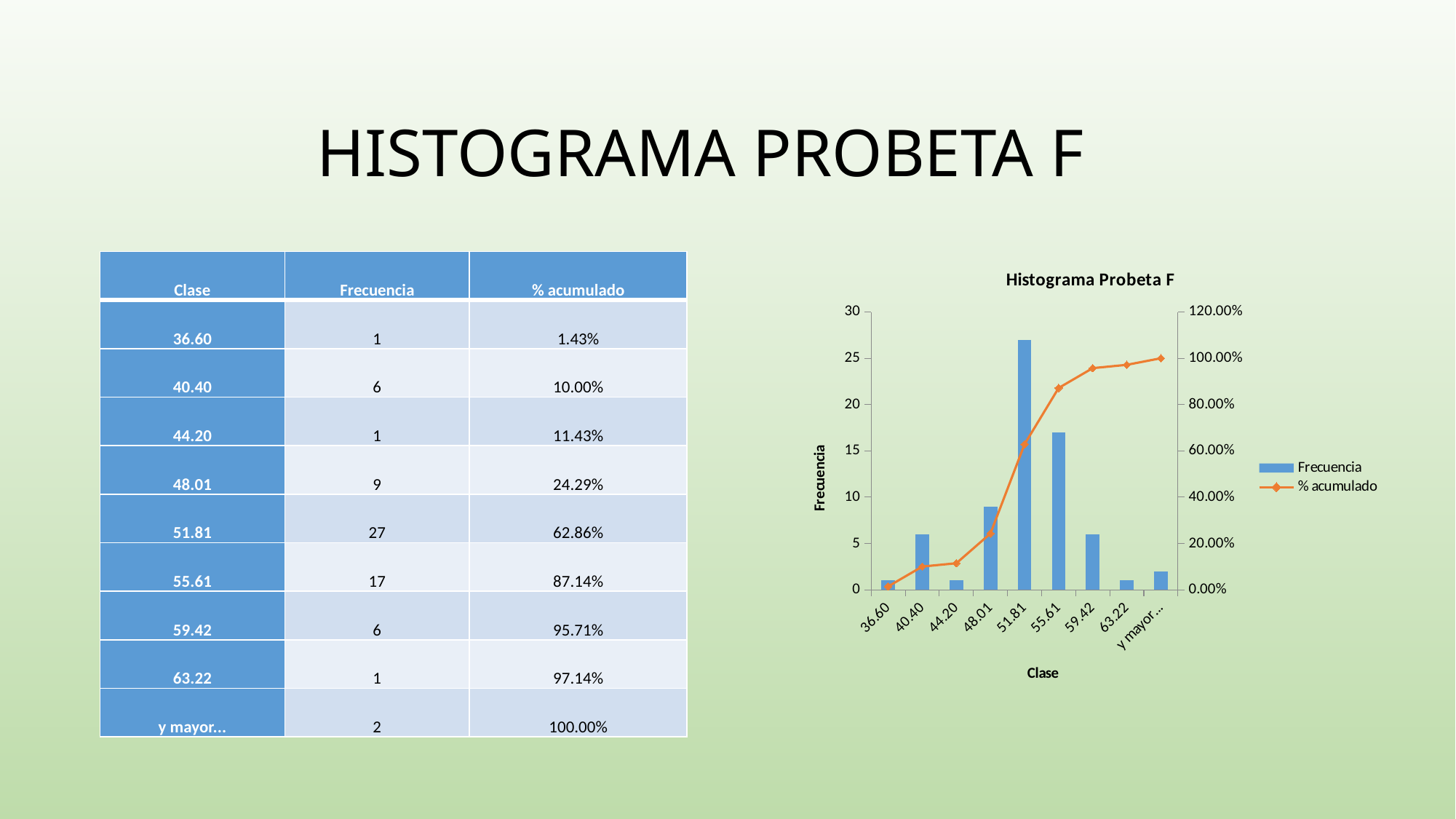
What type of chart is shown on the slide? Combined bar and line chart Is the Frecuencia bar for class 51.81 greater or less than 25? greater Which is larger, the Frecuencia for class 40.40 or for class 48.01? 48.01 How many series does the chart legend list? 2 Does the % acumulado line rise or fall from left to right along the x axis? Rises Is the Frecuencia bar for class 48.01 greater or less than 10? less What is the Frecuencia value for class 51.81? 27 What is the Frecuencia value for class 55.61? 17 How many classes are shown along the x axis of the chart? 9 What is the % acumulado value for class 48.01? 24.29% Which class has the highest Frecuencia bar? 51.81 What is the difference between the Frecuencia for class 51.81 and class 55.61? 10